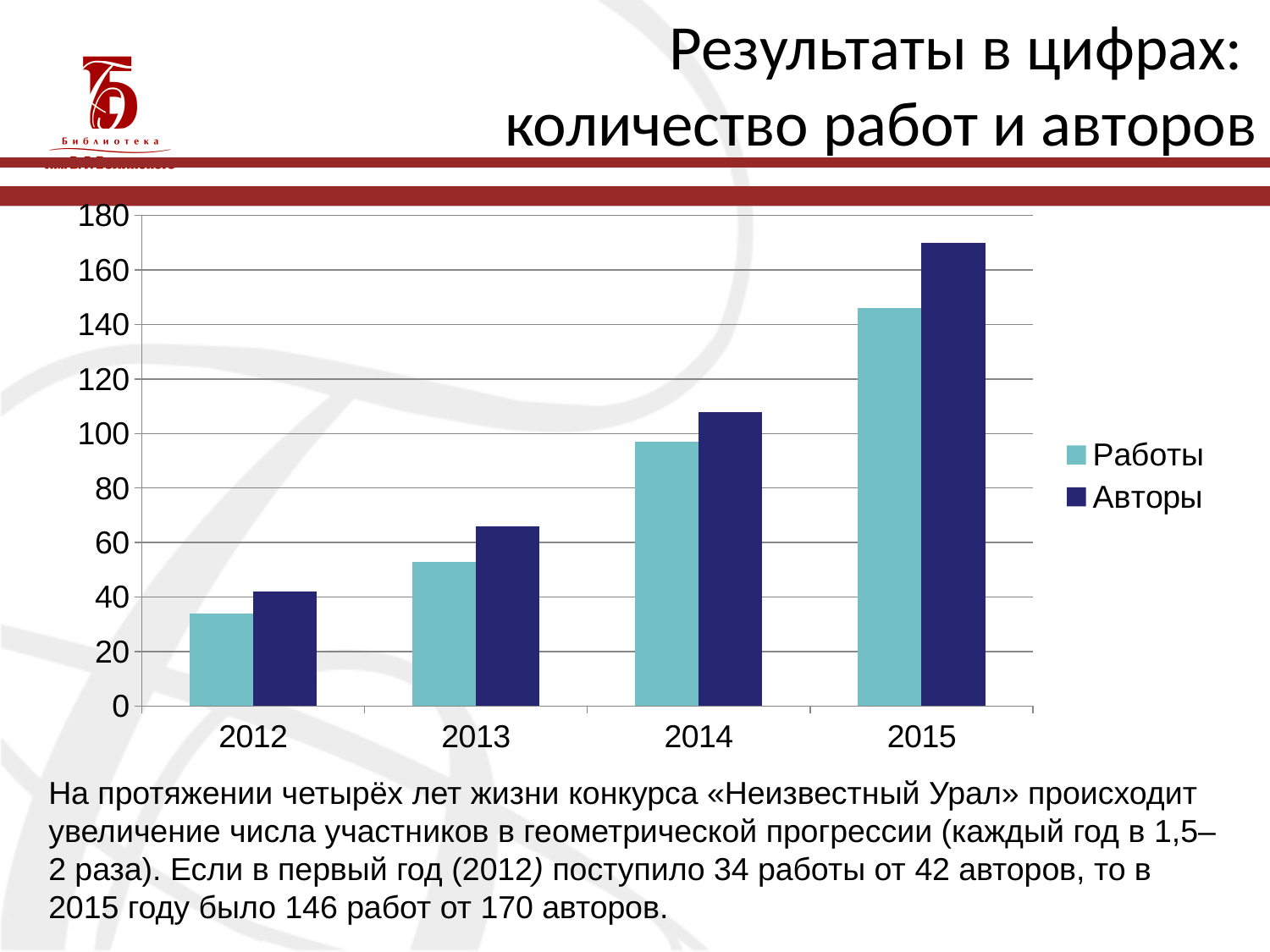
What is the value for Авторы in 2012? 42 What is the value for Работы in 2015? 146 Is the value for Работы in 2014 greater or less than 100? less Which year has the highest value for Авторы? 2015 Which year has the lowest value for Работы? 2012 In 2014, which is larger: Работы or Авторы? Авторы Is the value for Авторы in 2013 greater or less than 60? greater Do the values for Работы rise or fall from 2012 to 2015? Rise How many series does the chart legend list? 2 What kind of chart is shown on the slide? Bar chart How many years are shown on the x axis of the chart? 4 What is the difference between Авторы and Работы in 2015? 24